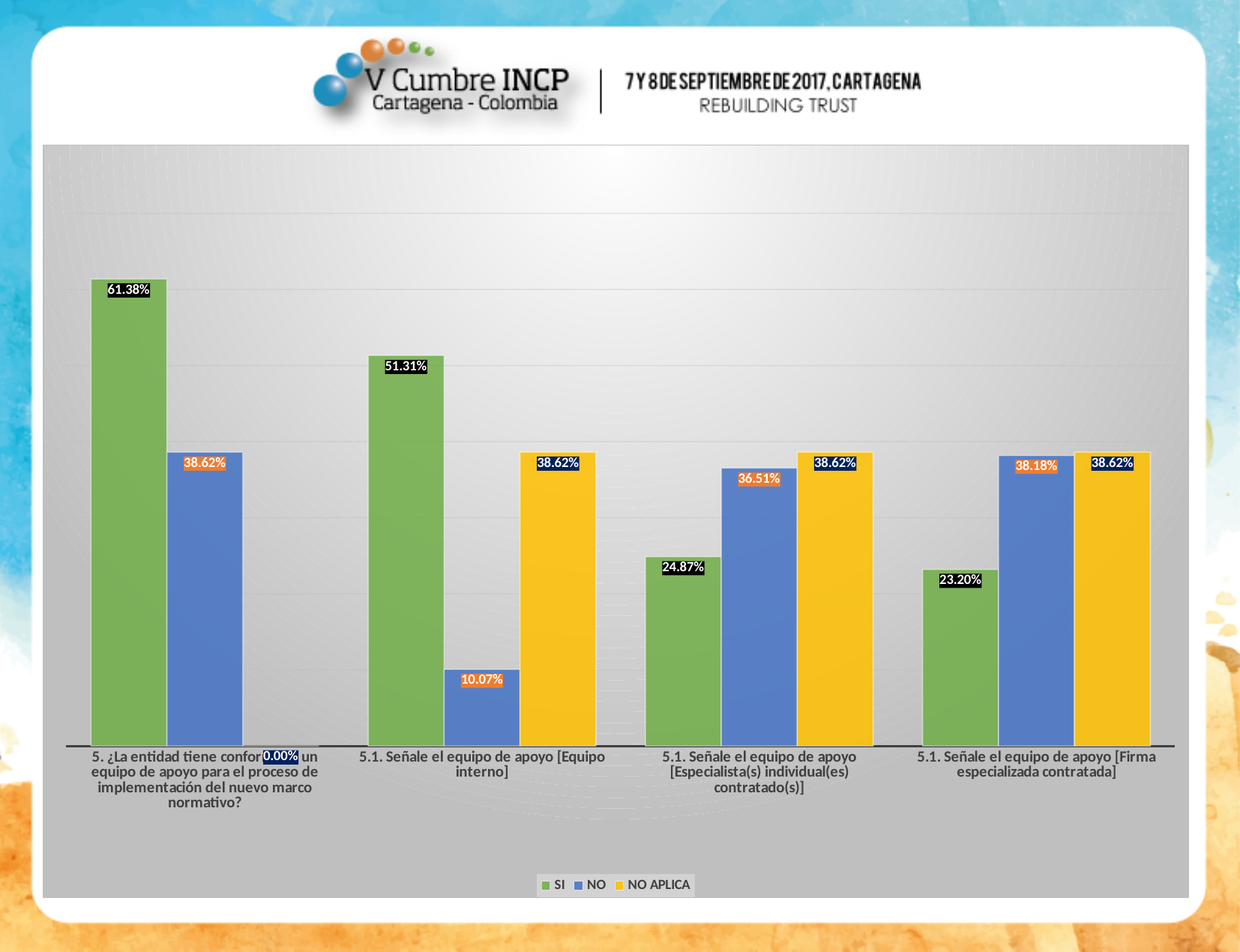
Which category has the highest SI value? 5. ¿La entidad tiene conformado un equipo de apoyo para el proceso de implementación del nuevo marco normativo? Which category has the lowest NO value? 5.1. Señale el equipo de apoyo [Equipo interno] How many categories are shown on the x axis? 4 Which series is shown in yellow in the legend? NO APLICA For "5.1. Señale el equipo de apoyo [Firma especializada contratada]", which is larger, the SI value or the NO value? NO What is the difference between the SI and NO values for "5.1. Señale el equipo de apoyo [Equipo interno]"? 41.24% What kind of chart is shown on the slide? bar chart How many series does the legend list? 3 What is the SI value for "5.1. Señale el equipo de apoyo [Firma especializada contratada]"? 23.20% What is the SI value for "5.1. Señale el equipo de apoyo [Equipo interno]"? 51.31% What is the NO value for "5.1. Señale el equipo de apoyo [Equipo interno]"? 10.07% What is the NO value for "5.1. Señale el equipo de apoyo [Especialista(s) individual(es) contratado(s)]"? 36.51%